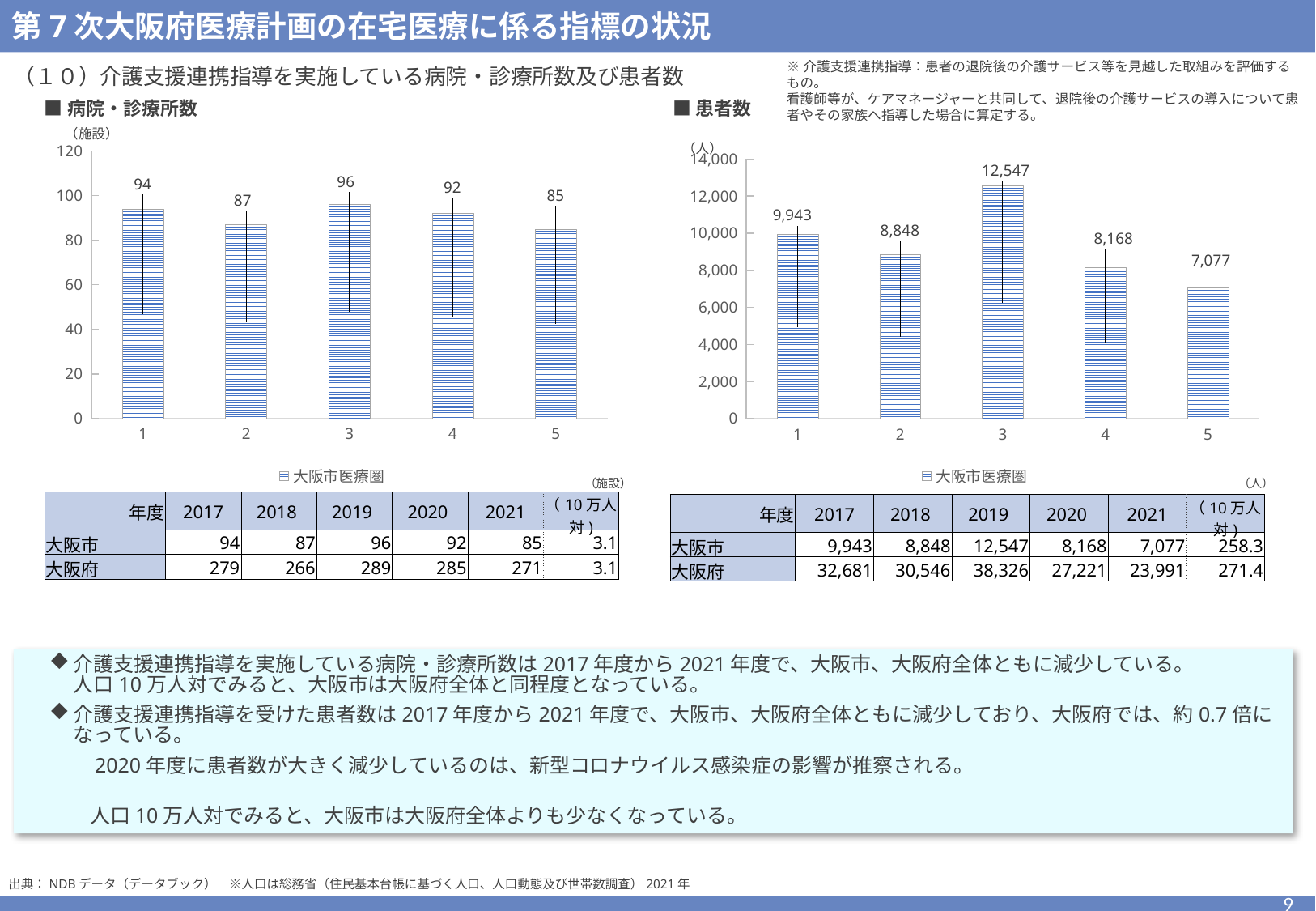
In the 病院・診療所数 chart on the left, what is the difference between the values for category 3 and category 2? 9 In the 患者数 chart on the right, what is the value for category 1? 9,943 In the 病院・診療所数 chart on the left, what is the value for category 5? 85 How many bars are plotted in the 患者数 chart on the right? 5 What kind of chart is the 病院・診療所数 chart on the left? bar chart In the 患者数 chart on the right, which is larger, the value for category 2 or category 4? category 2 What series name does the legend of the 患者数 chart on the right show? 大阪市医療圏 In the 患者数 chart on the right, what is the difference between the values for category 3 and category 4? 4,379 In the 病院・診療所数 chart on the left, which category has the lowest value? 5 In the 患者数 chart on the right, which category has the highest value? 3 In the 患者数 chart on the right, what is the value for category 5? 7,077 In the 病院・診療所数 chart on the left, what is the value for category 3? 96